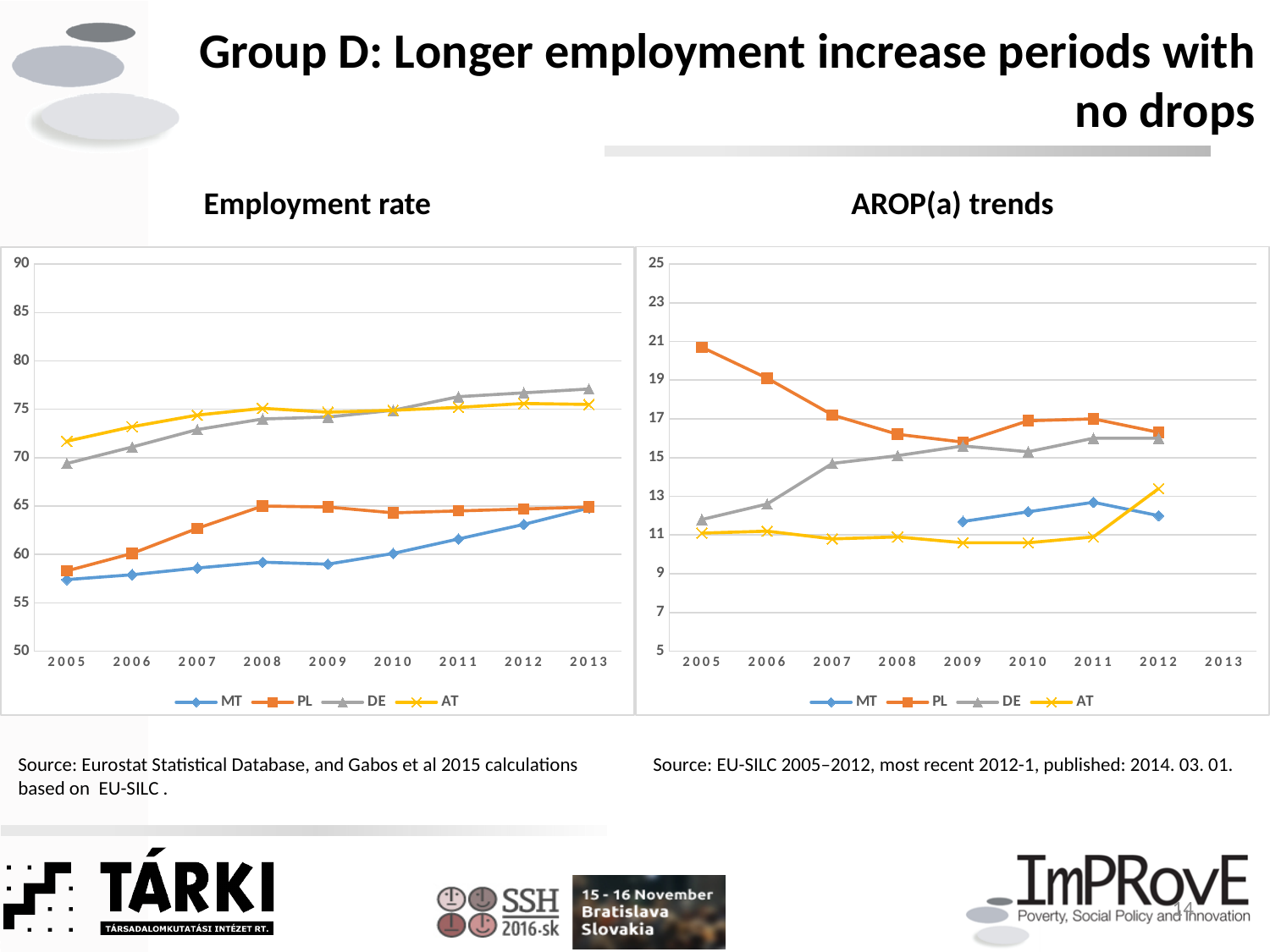
In the AROP(a) trends chart, which series has the highest value in 2005? PL In the AROP(a) trends chart, which series has the lowest value in 2009? AT In the Employment rate chart, which series has the highest value in 2005? AT How many years are shown on the x axis of the Employment rate chart? 9 In the AROP(a) trends chart, does the PL series rise or fall from 2005 to 2009? fall In the AROP(a) trends chart, is the value for PL in 2005 greater or less than 19? greater How many series does the legend of the AROP(a) trends chart list? 4 What kind of chart is the Employment rate chart? line chart In the Employment rate chart, is the value for DE in 2013 greater or less than 75? greater In the Employment rate chart, is the value for PL in 2005 greater or less than 60? less In the Employment rate chart, does the MT series rise or fall from 2005 to 2013? rise In the Employment rate chart, which series has the highest value in 2013? DE